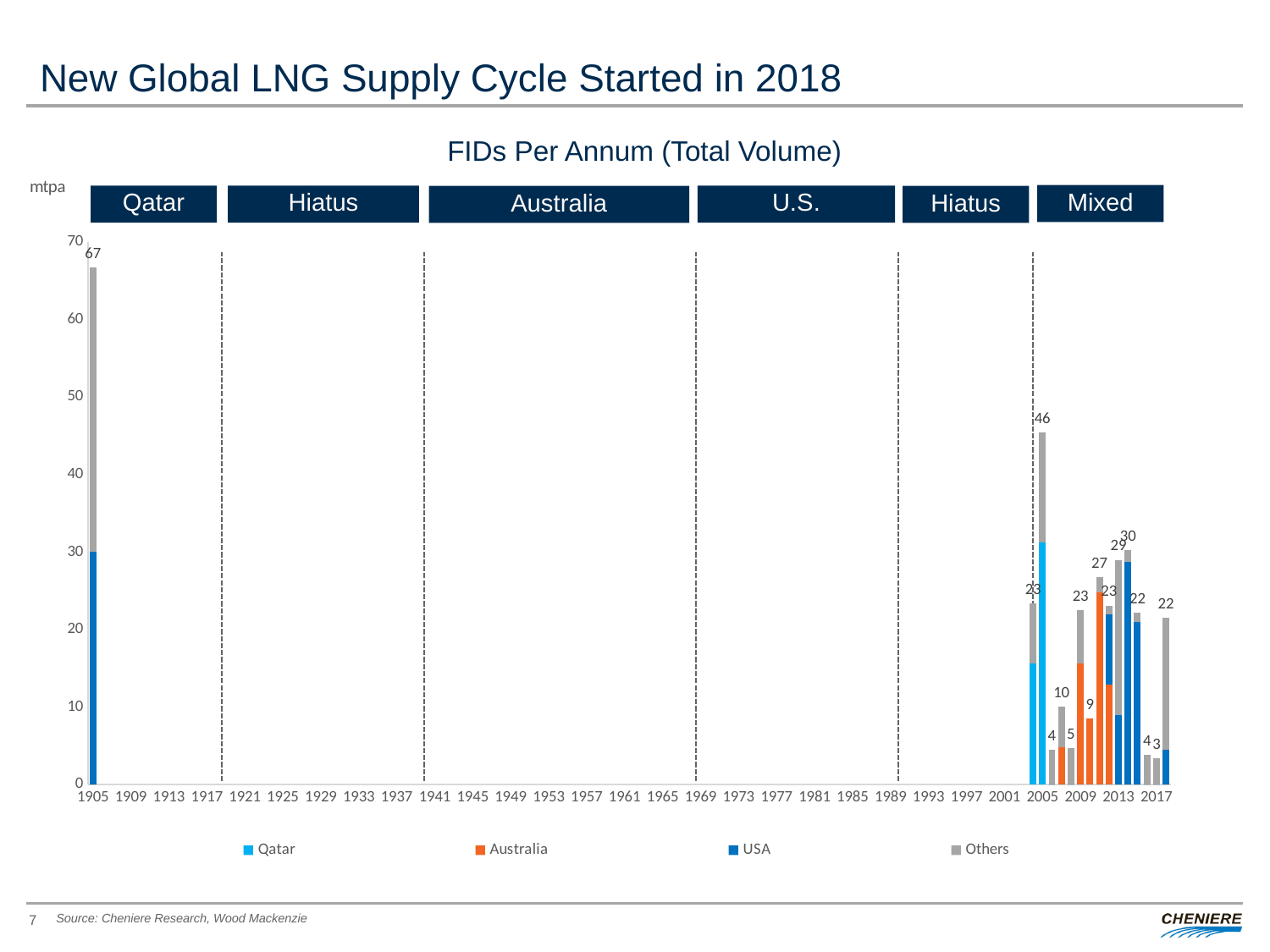
How many series does the chart legend list? 4 Which series in the legend is shown in orange? Australia What unit is shown on the y axis of the chart? mtpa What is the difference between the highest labeled bar total (67) and the second highest (46)? 21 What is the maximum tick value shown on the y axis? 70 What is the highest total value labeled on any bar in the chart? 67 What is the lowest total value labeled on any bar in the chart? 3 What is the title of the chart? FIDs Per Annum (Total Volume) Is the tallest bar in the chart greater or less than 60 mtpa? greater What is the total value labeled on the first bar at the far left of the chart? 67 What kind of chart is shown on the slide? Stacked bar chart Which is larger: the bar labeled 46 or the bar labeled 30? 46